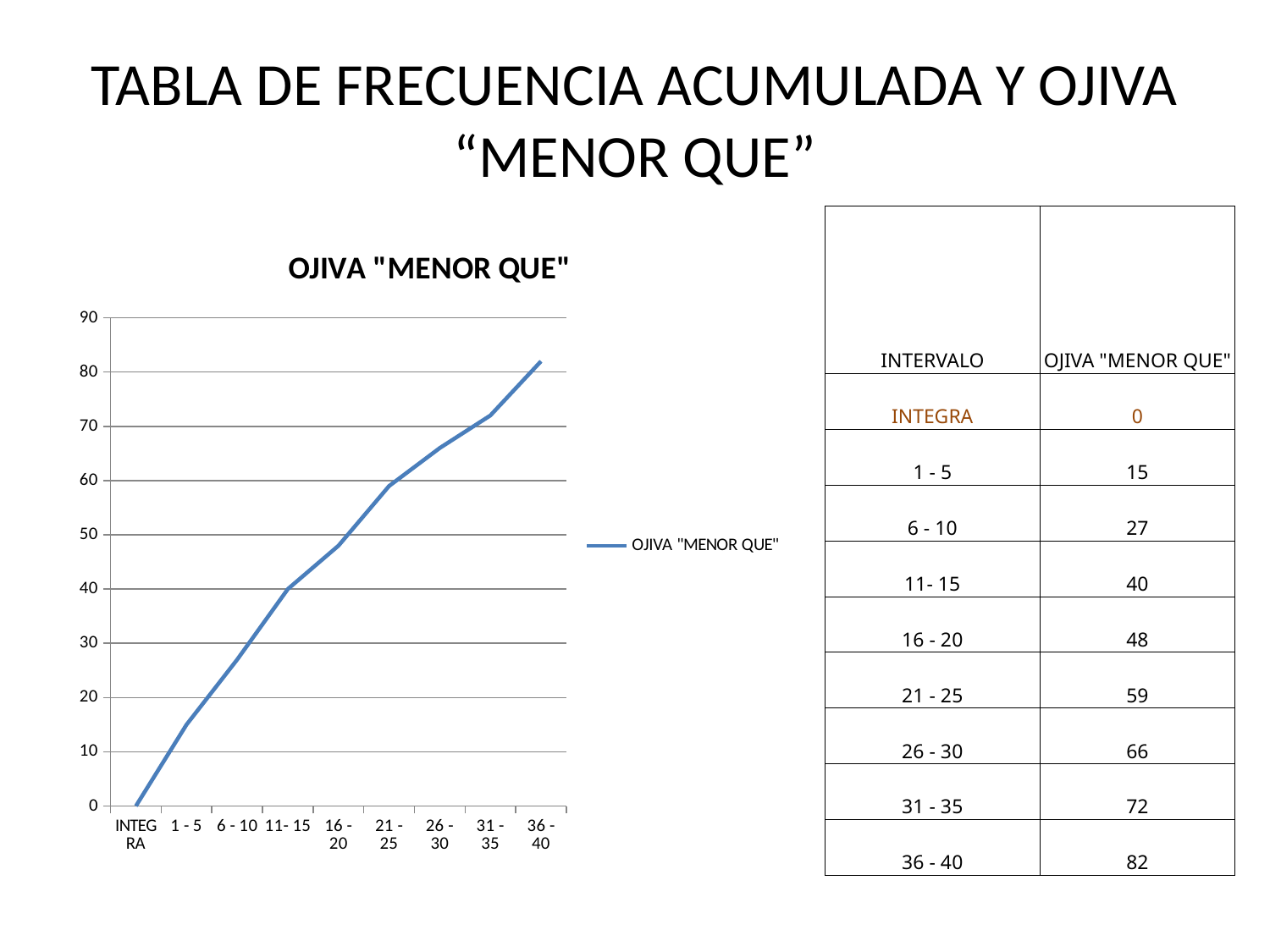
What kind of chart is shown on the slide? line chart How many series does the chart legend list? 1 Is the value for 21 - 25 greater or less than 50? greater Do the values of the OJIVA "MENOR QUE" line rise or fall along the x axis? rise What is the value for the interval 11- 15? 40 Is the value for 6 - 10 greater or less than 30? less Which category has the lowest value on the chart? INTEGRA What is the value for the interval 36 - 40? 82 What is the title of the chart? OJIVA "MENOR QUE" How many categories are plotted along the x axis of the chart? 9 Which category has the highest value on the chart? 36 - 40 What is the difference between the values for 36 - 40 and 31 - 35? 10